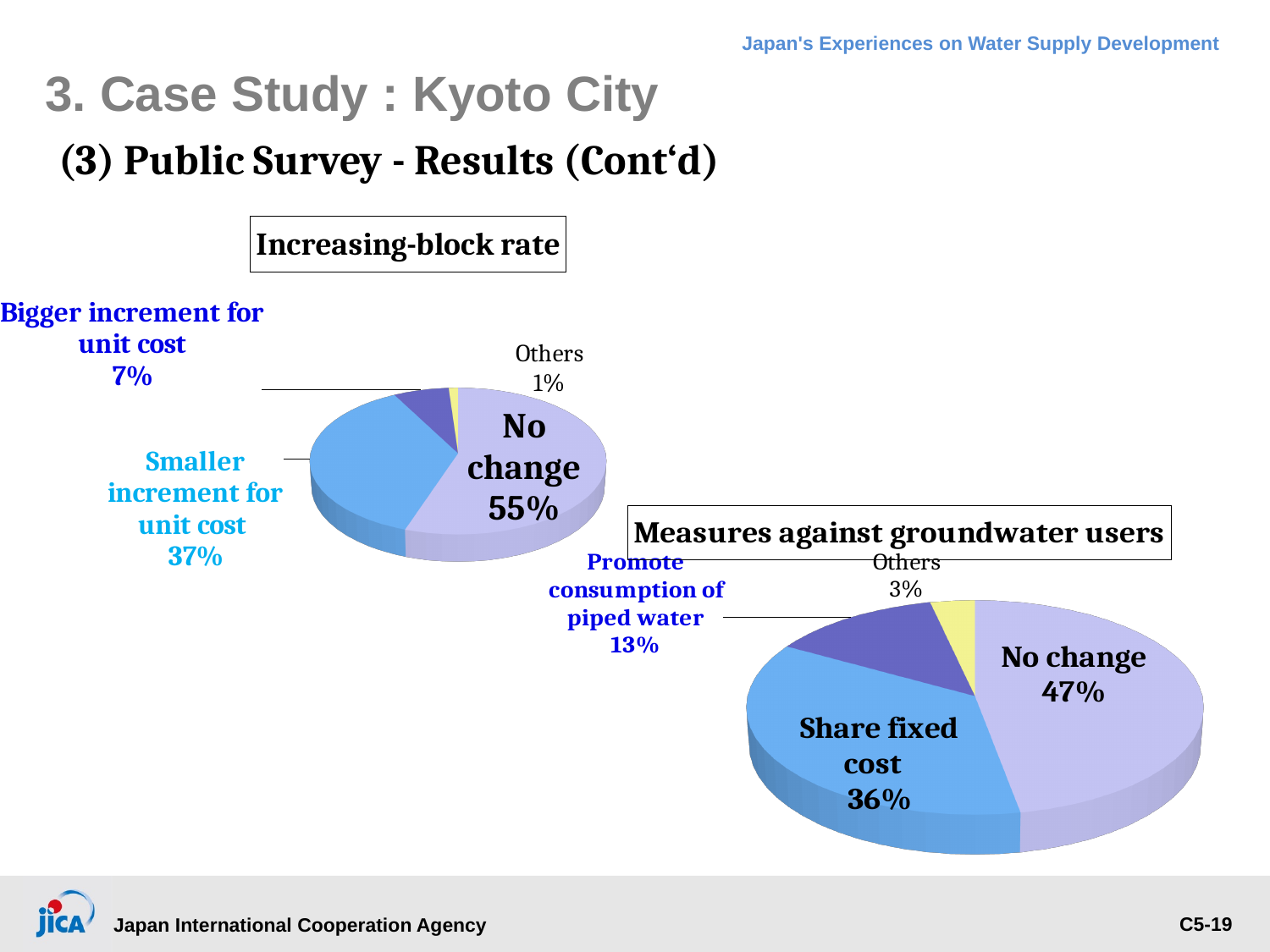
In the 'Measures against groundwater users' chart, what share is 'Share fixed cost'? 36% In the 'Increasing-block rate' chart, what share is 'Smaller increment for unit cost'? 37% In the 'Increasing-block rate' chart, what is the difference between 'No change' and 'Smaller increment for unit cost'? 18% In the 'Measures against groundwater users' chart, what is the difference between 'Share fixed cost' and 'Promote consumption of piped water'? 23% In the 'Increasing-block rate' chart, which category has the smallest share? Others In the 'Increasing-block rate' chart, what share is 'Bigger increment for unit cost'? 7% How many slices does the 'Increasing-block rate' chart have? 4 In the 'Measures against groundwater users' chart, which category has the largest share? No change What type of chart is the 'Measures against groundwater users' chart? Pie chart In the 'Measures against groundwater users' chart, which is larger, 'No change' or 'Share fixed cost'? No change In the 'Increasing-block rate' chart, what share is 'No change'? 55% In the 'Measures against groundwater users' chart, what share is 'Promote consumption of piped water'? 13%